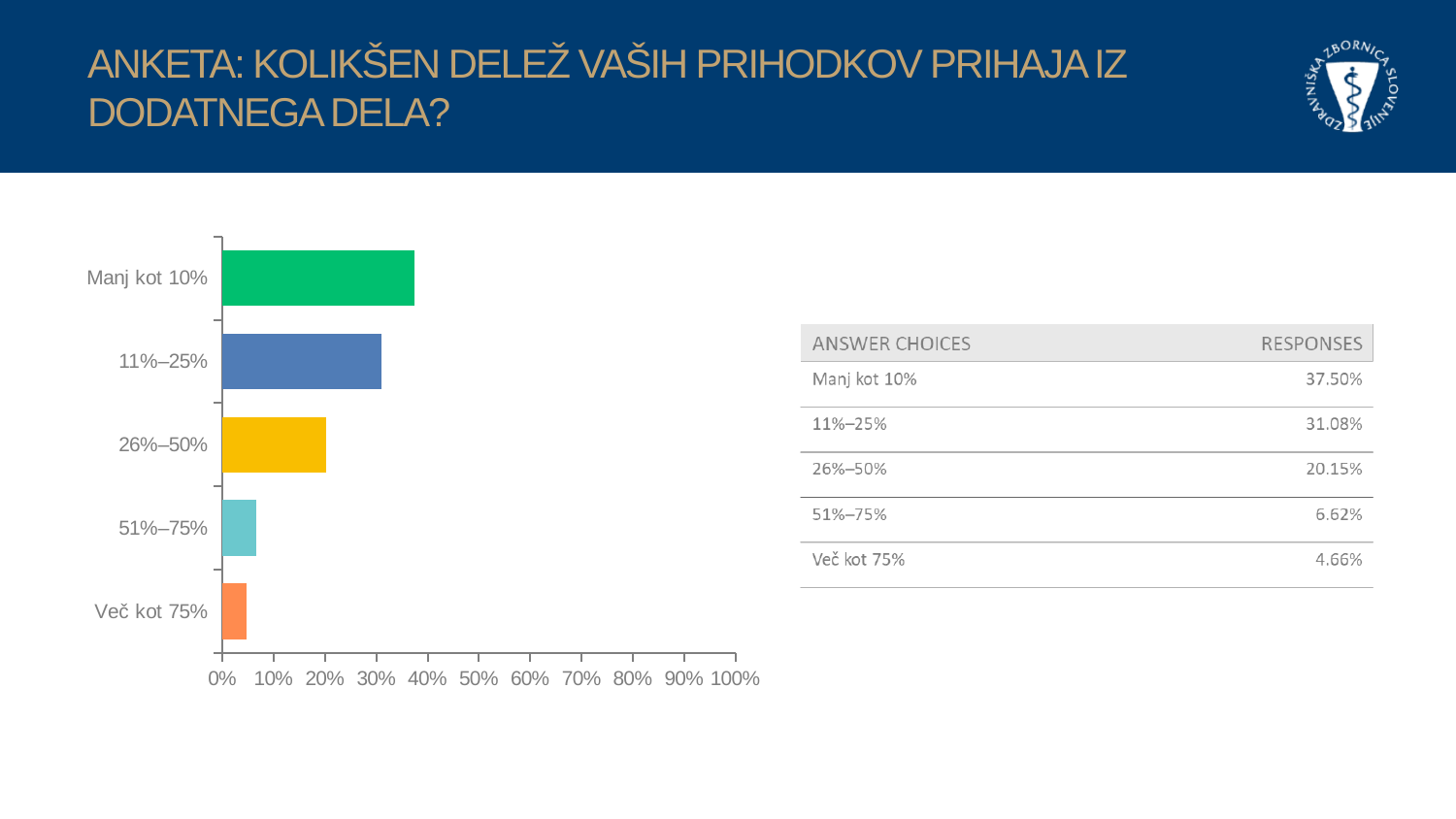
Which category has the highest value in the bar chart? Manj kot 10% Which category has the lowest value in the bar chart? Več kot 75% Is the value for "Več kot 75%" greater or less than 10%? less Is the value for "Manj kot 10%" greater or less than 30%? greater What colour is the bar for "26%–50%"? yellow What is the difference between the values for "Manj kot 10%" and "11%–25%"? 6.42% How many categories does the bar chart show? 5 What kind of chart is shown on the slide? bar chart What is the response share for "26%–50%"? 20.15% Which is larger, the value for "11%–25%" or the value for "26%–50%"? 11%–25% What is the response share for "51%–75%"? 6.62% What is the response share for "Manj kot 10%"? 37.50%